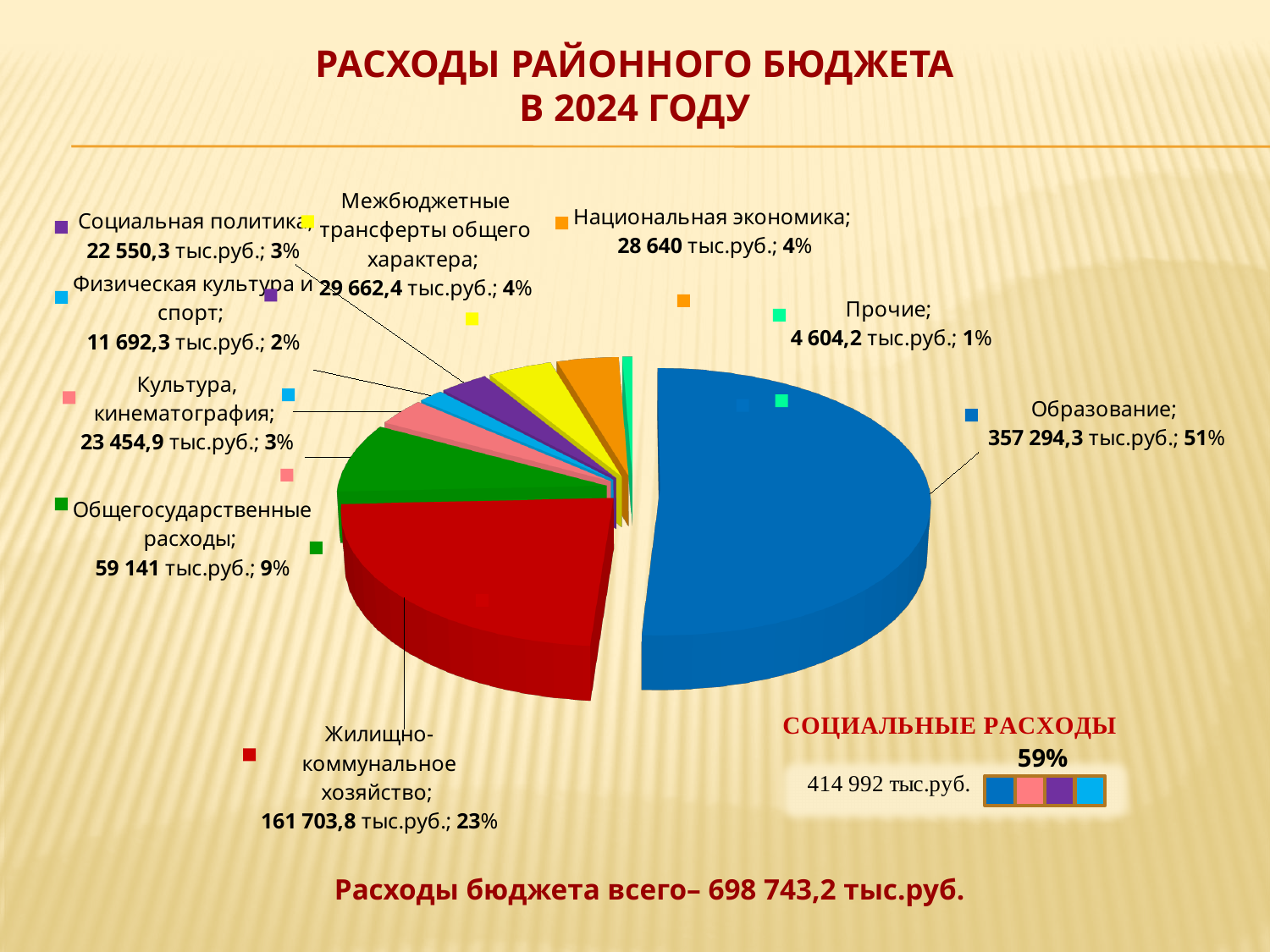
What is the value for Образование? 357 294,3 тыс.руб. Which category has the smallest slice of the pie? Прочие What is the value for Общегосударственные расходы? 59 141 тыс.руб. Which category has the largest slice of the pie? Образование What is the title of the chart on the slide? РАСХОДЫ РАЙОННОГО БЮДЖЕТА В 2024 ГОДУ How many categories are shown in the pie chart? 9 What share of the pie does Физическая культура и спорт represent? 2% What is the difference between Межбюджетные трансферты общего характера and Национальная экономика? 1 022,4 тыс.руб. Which is larger: Национальная экономика or Социальная политика? Национальная экономика What is the value for Культура, кинематография? 23 454,9 тыс.руб. What type of chart is shown on the slide? pie chart What share of the pie does Жилищно-коммунальное хозяйство represent? 23%